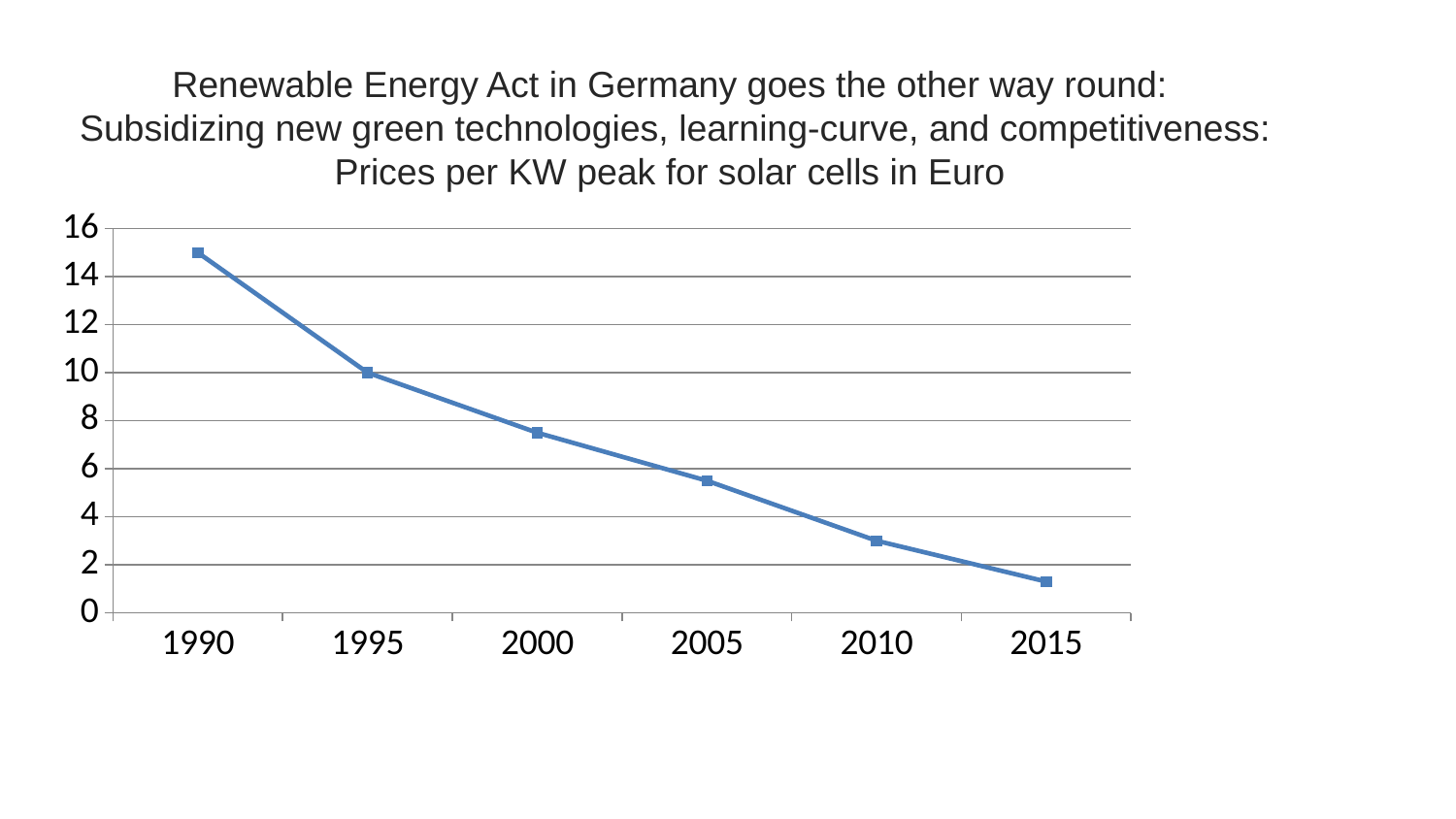
Which is larger, the value for 2000 or the value for 2010? 2000 What is the price per KW peak in 1995? 10 What unit are the prices per KW peak given in, according to the title? Euro What kind of chart is shown on the slide? line chart How many data points are plotted on the line? 6 Is the value for 2005 greater or less than 4? greater Is the value for 2000 greater or less than 8? less Do the prices rise or fall from 1990 to 2015? fall Which year has the highest price per KW peak? 1990 Is the value for 2015 greater or less than 2? less Which year has the lowest price per KW peak? 2015